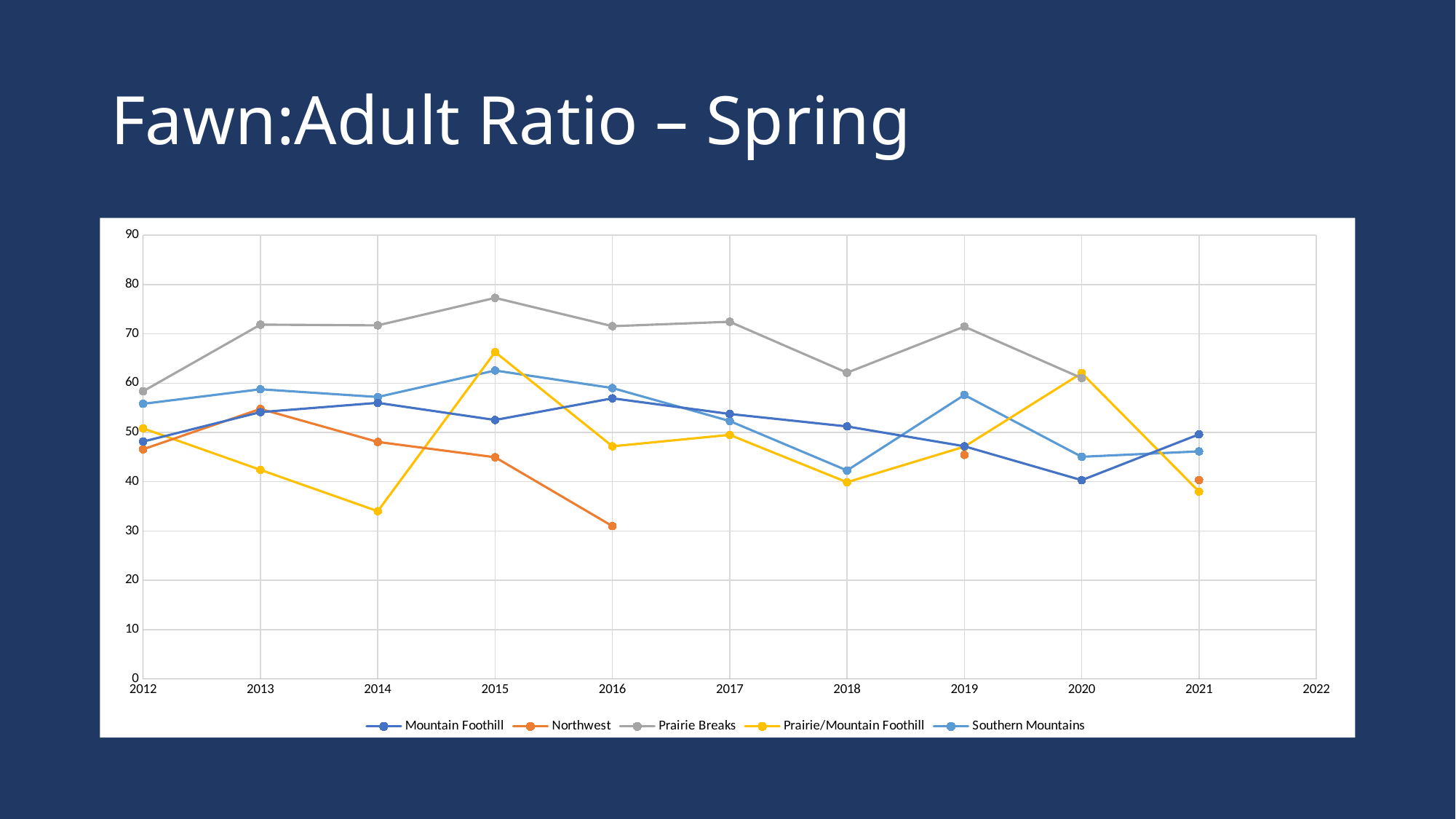
What is the title of the slide containing the chart? Fawn:Adult Ratio – Spring In 2020, which is larger: the value for Prairie/Mountain Foothill or the value for Mountain Foothill? Prairie/Mountain Foothill Which series has the lowest value in 2016? Northwest In which year does the Prairie/Mountain Foothill series reach its highest value? 2015 In which year does the Mountain Foothill series reach its lowest value? 2020 What kind of chart is shown on the slide? Line chart Is the value for Prairie/Mountain Foothill in 2014 greater or less than 40? less Does the Prairie Breaks series rise or fall from 2019 to 2020? Fall Which series has the highest value in 2015? Prairie Breaks How many series does the legend list? 5 Is the value for Prairie Breaks in 2015 greater or less than 70? greater Is the value for Northwest in 2016 greater or less than 40? less